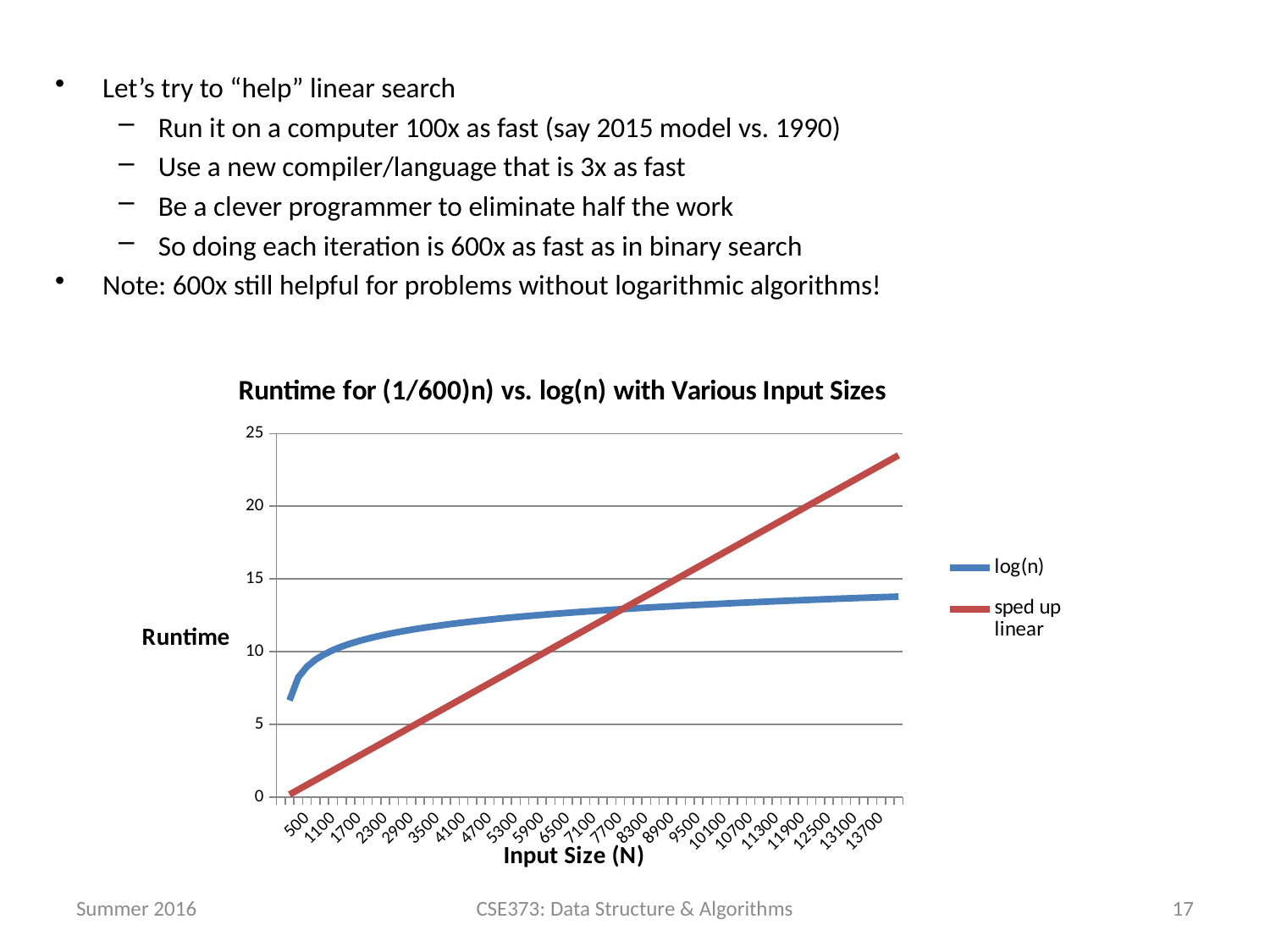
Does the sped up linear series rise or fall as input size increases? rise How many series does the legend list? 2 Is the value of the log(n) series at input size 500 greater or less than 5? greater At input size 13700, which series has the larger runtime, log(n) or sped up linear? sped up linear Is the value of the log(n) series at input size 13700 greater or less than 15? less What kind of chart is shown on the slide? line chart At input size 500, which series has the larger runtime, log(n) or sped up linear? log(n) Is the value of the sped up linear series at input size 13700 greater or less than 20? greater Does the log(n) series rise or fall as input size increases? rise What is the title of the chart? Runtime for (1/600)n) vs. log(n) with Various Input Sizes What are the two series named in the legend? log(n) and sped up linear